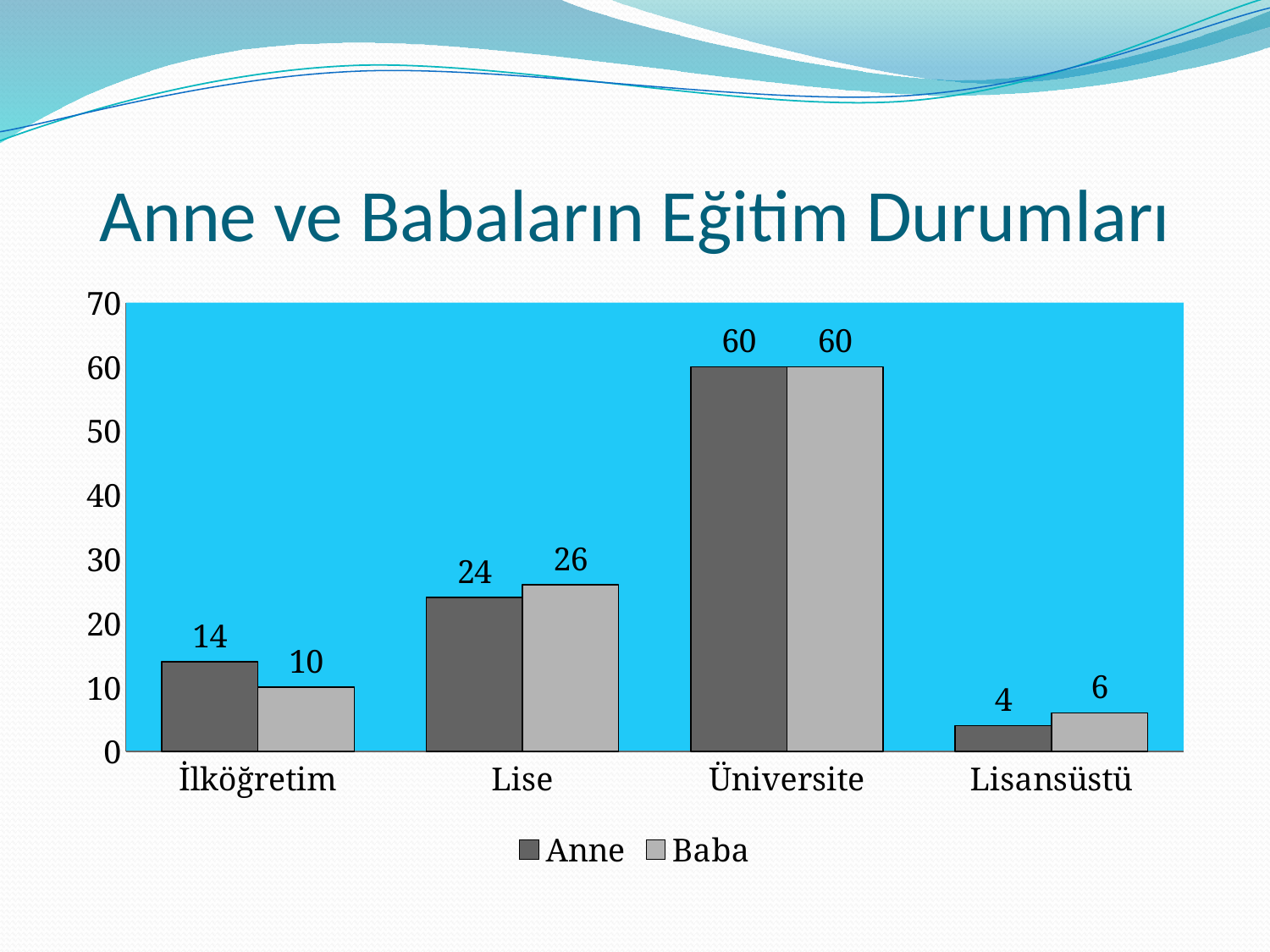
What is the difference between the Baba and Anne values in the Lise category? 2 Which category has the lowest value for Baba? Lisansüstü What kind of chart is shown on the slide? Bar chart Which category has the highest value for Anne? Üniversite What is the difference between the Anne and Baba values in the İlköğretim category? 4 Which is larger in the İlköğretim category, Anne or Baba? Anne What is the value for Baba in the Lisansüstü category? 6 What is the value for Anne in the Lise category? 24 How many series does the legend list? 2 What is the value for Baba in the İlköğretim category? 10 What is the title of the slide? Anne ve Babaların Eğitim Durumları How many categories are shown on the x axis? 4